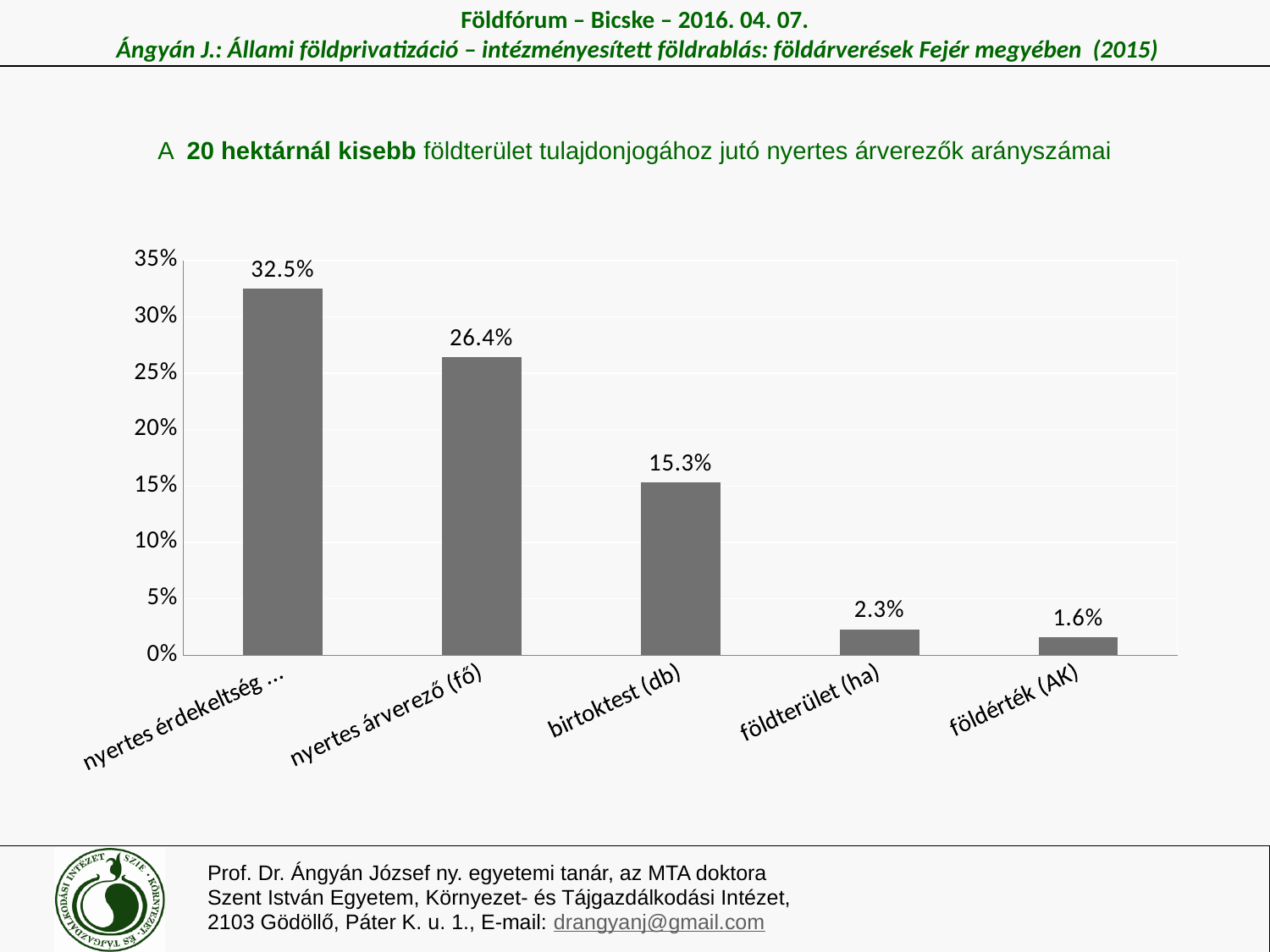
What is the difference between the values for földterület (ha) and földérték (AK)? 0.7% Which is larger, the value for birtoktest (db) or the value for földterület (ha)? birtoktest (db) What is the difference between the values for nyertes árverező (fő) and birtoktest (db)? 11.1% What is the value for birtoktest (db)? 15.3% What is the value for nyertes árverező (fő)? 26.4% What kind of chart is shown on the slide? bar chart Which category has the lowest value? földérték (AK) Is the value for nyertes árverező (fő) greater or less than 25%? greater Do the values rise or fall from left to right along the x axis? fall What is the value for földterület (ha)? 2.3% What is the value for földérték (AK)? 1.6% How many categories are shown on the x axis? 5